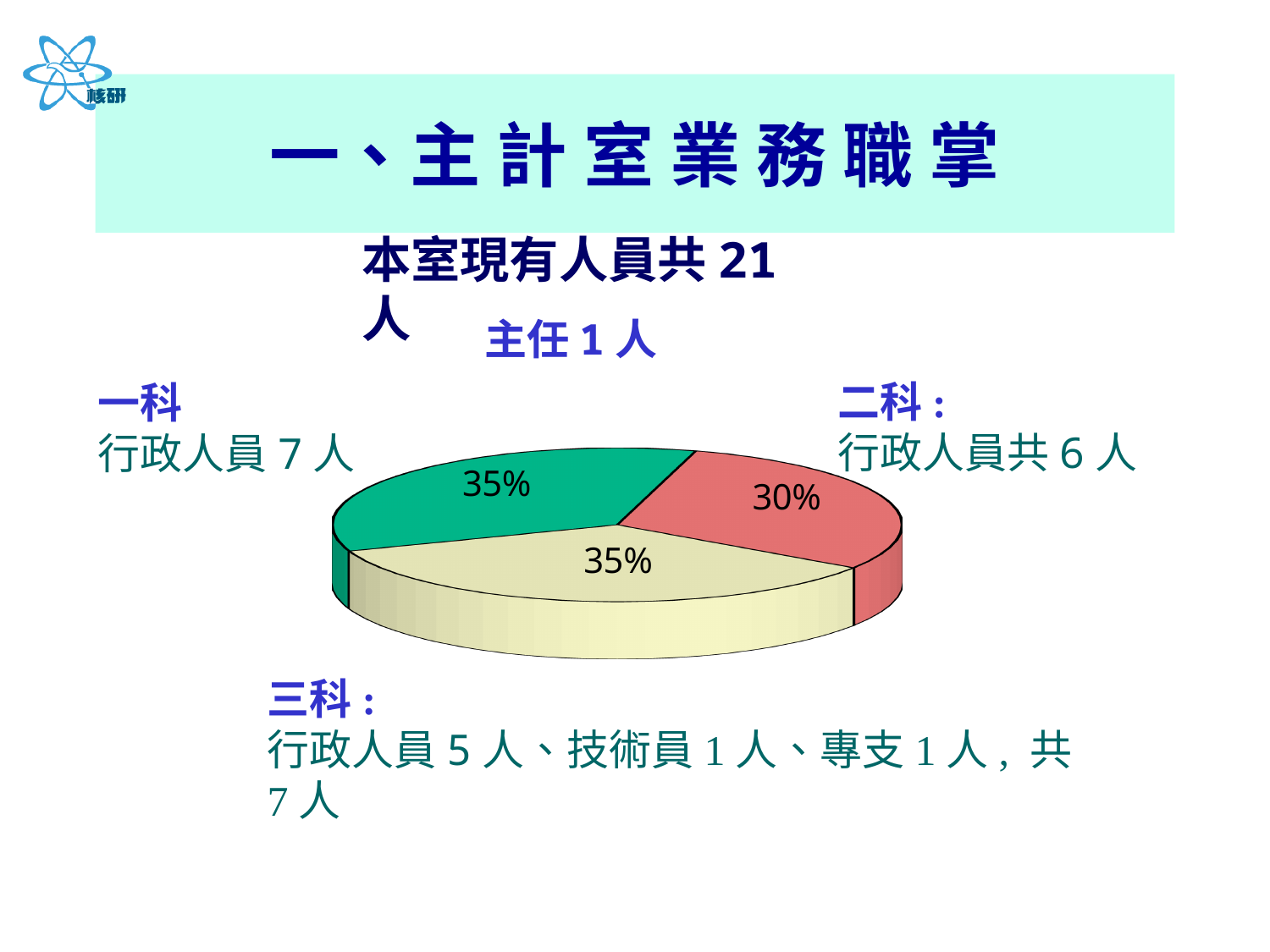
Which slice of the pie chart is the smallest? the red slice (30%) Is the value of the red slice greater or less than 35%? less What is the difference in percentage points between the green slice and the red slice? 5 What kind of chart is shown on the slide? pie chart How many slices does the pie chart have? 3 What percentage is shown on the red slice of the pie chart? 30% What percentage is shown on the green slice of the pie chart? 35% What percentage is shown on the cream-coloured slice of the pie chart? 35% Which is larger in the pie chart, the green slice or the red slice? the green slice Do the green and cream slices of the pie chart show the same percentage? yes, both 35% Is the pie chart drawn in 3D or flat 2D? 3D What is the combined percentage of the green and cream slices? 70%